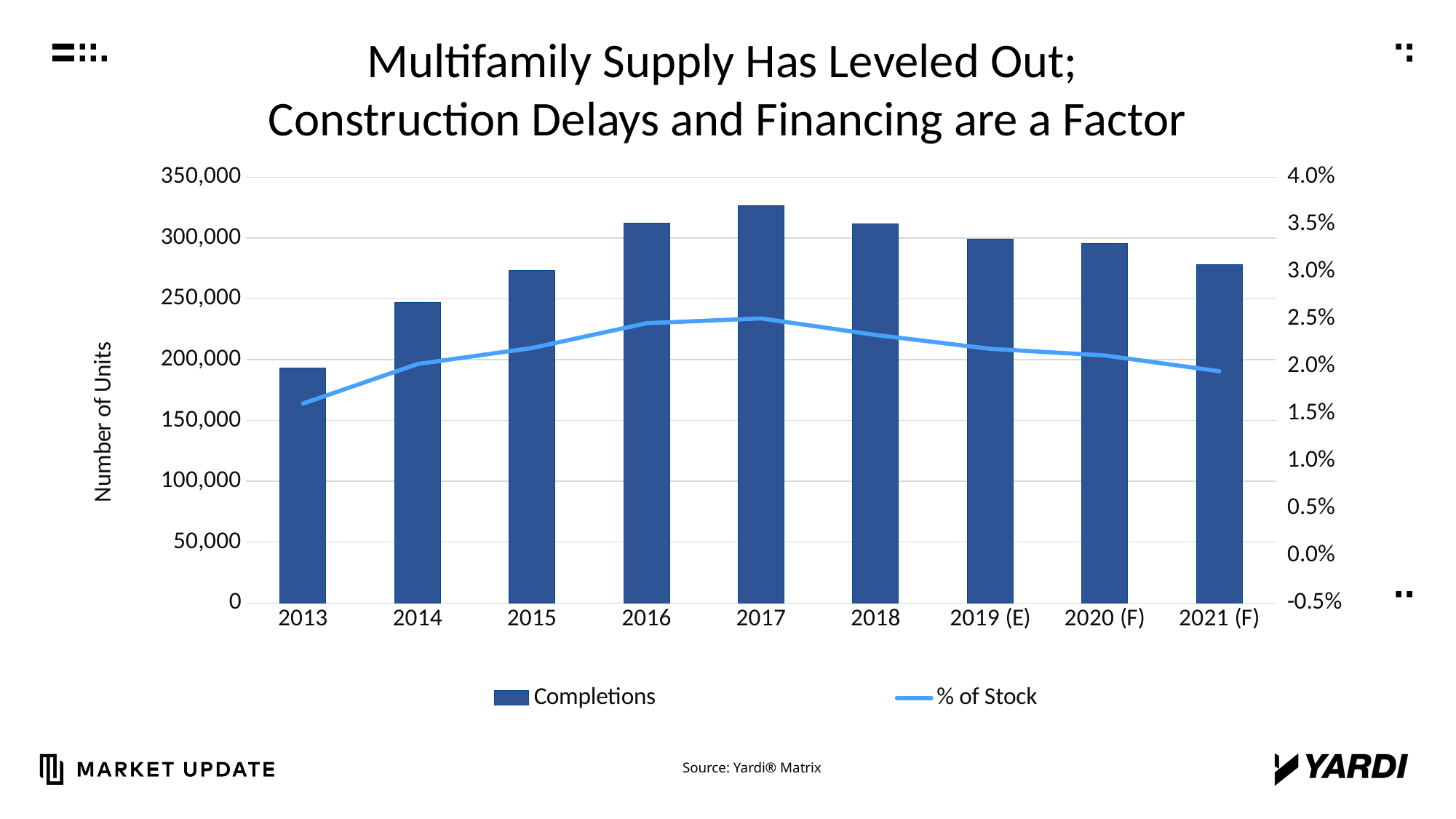
Which year has more Completions, 2016 or 2021 (F)? 2016 How many years are shown on the x axis of the chart? 9 Is the Completions value for 2013 greater or less than 200,000? less What is the label on the left vertical axis of the chart? Number of Units Is the Completions value for 2017 greater or less than 300,000? greater Is the % of Stock value for 2017 greater or less than 2.0%? greater What kind of chart is shown on the slide? A combination bar and line chart Which year has the highest number of Completions? 2017 How many series does the chart's legend list? 2 Do Completions rise or fall from 2017 to 2021 (F)? fall Which year has the lowest number of Completions? 2013